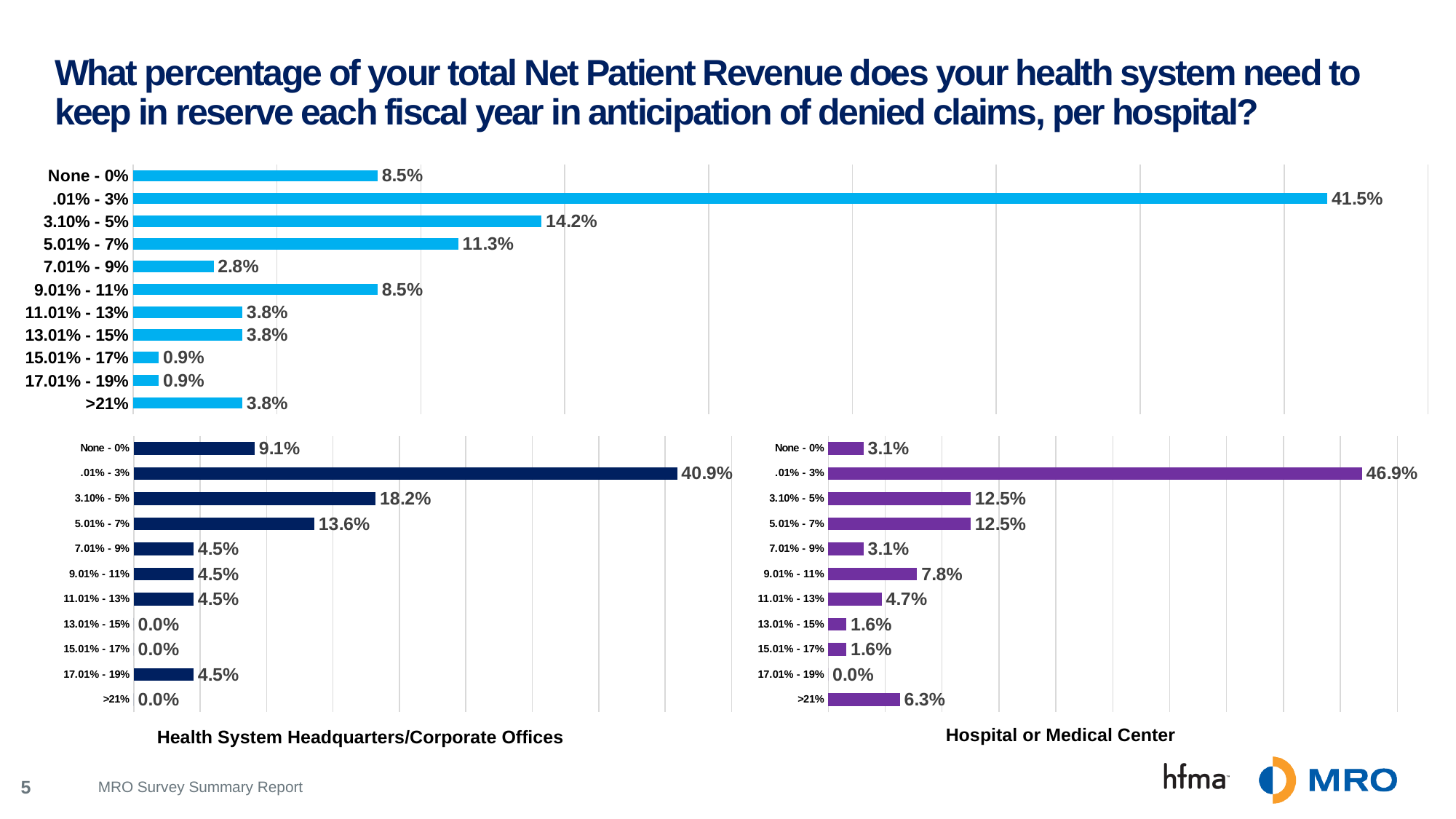
Which chart has the higher value for ".01% - 3%", the Health System Headquarters/Corporate Offices chart or the Hospital or Medical Center chart? Hospital or Medical Center In the Health System Headquarters/Corporate Offices chart, what is the value for "3.10% - 5%"? 18.2% In the top chart, what is the difference between the values for "3.10% - 5%" and "5.01% - 7%"? 2.9% In the Health System Headquarters/Corporate Offices chart, which category has the highest value? .01% - 3% How many categories does the top chart show? 11 In the top chart, what is the value for the ".01% - 3%" category? 41.5% What type of chart is the Hospital or Medical Center chart? Bar chart In the Hospital or Medical Center chart, what is the value for "9.01% - 11%"? 7.8% In the top chart, which category has the highest value? .01% - 3% In the Hospital or Medical Center chart, what is the value for ".01% - 3%"? 46.9% In the Health System Headquarters/Corporate Offices chart, what is the value for ">21%"? 0.0% In the Hospital or Medical Center chart, which is larger, the value for "9.01% - 11%" or the value for ">21%"? 9.01% - 11%